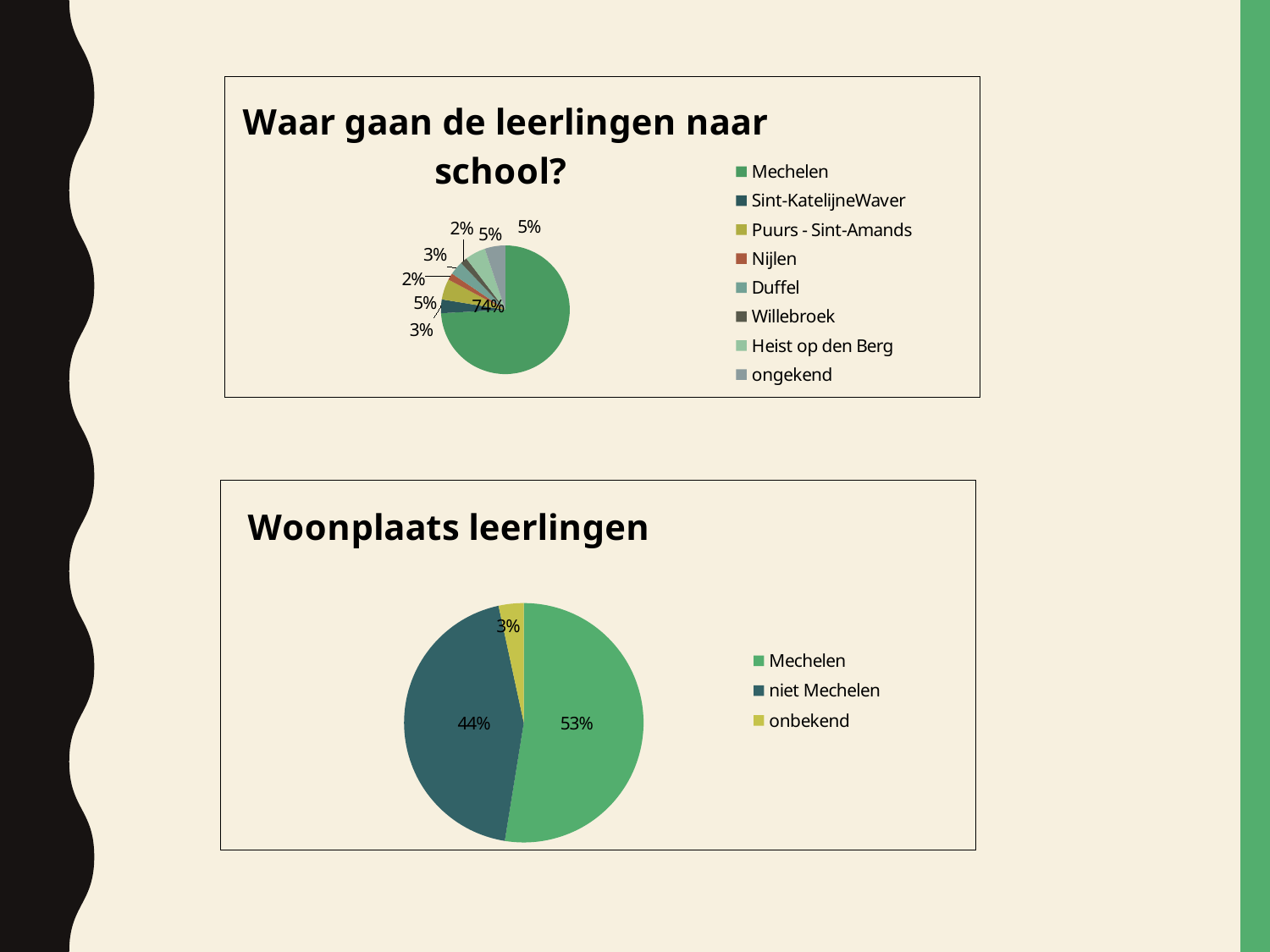
In the chart titled "Woonplaats leerlingen", what share of the pie is Mechelen? 53% In the chart titled "Woonplaats leerlingen", how many categories does the legend list? 3 In the chart titled "Woonplaats leerlingen", what share of the pie is niet Mechelen? 44% In the chart titled "Woonplaats leerlingen", which category has the smallest slice? onbekend In the chart titled "Woonplaats leerlingen", which category has the largest slice? Mechelen In the chart titled "Waar gaan de leerlingen naar school?", what share of the pie is Mechelen? 74% In the chart titled "Waar gaan de leerlingen naar school?", how many categories does the legend list? 8 In the chart titled "Waar gaan de leerlingen naar school?", which category has the largest slice? Mechelen In the chart titled "Woonplaats leerlingen", what is the difference in percentage points between Mechelen and niet Mechelen? 9 In the chart titled "Woonplaats leerlingen", is the slice for Mechelen larger or smaller than the slice for niet Mechelen? larger In the chart titled "Woonplaats leerlingen", what share of the pie is onbekend? 3% What kind of chart is the chart titled "Waar gaan de leerlingen naar school?"? pie chart